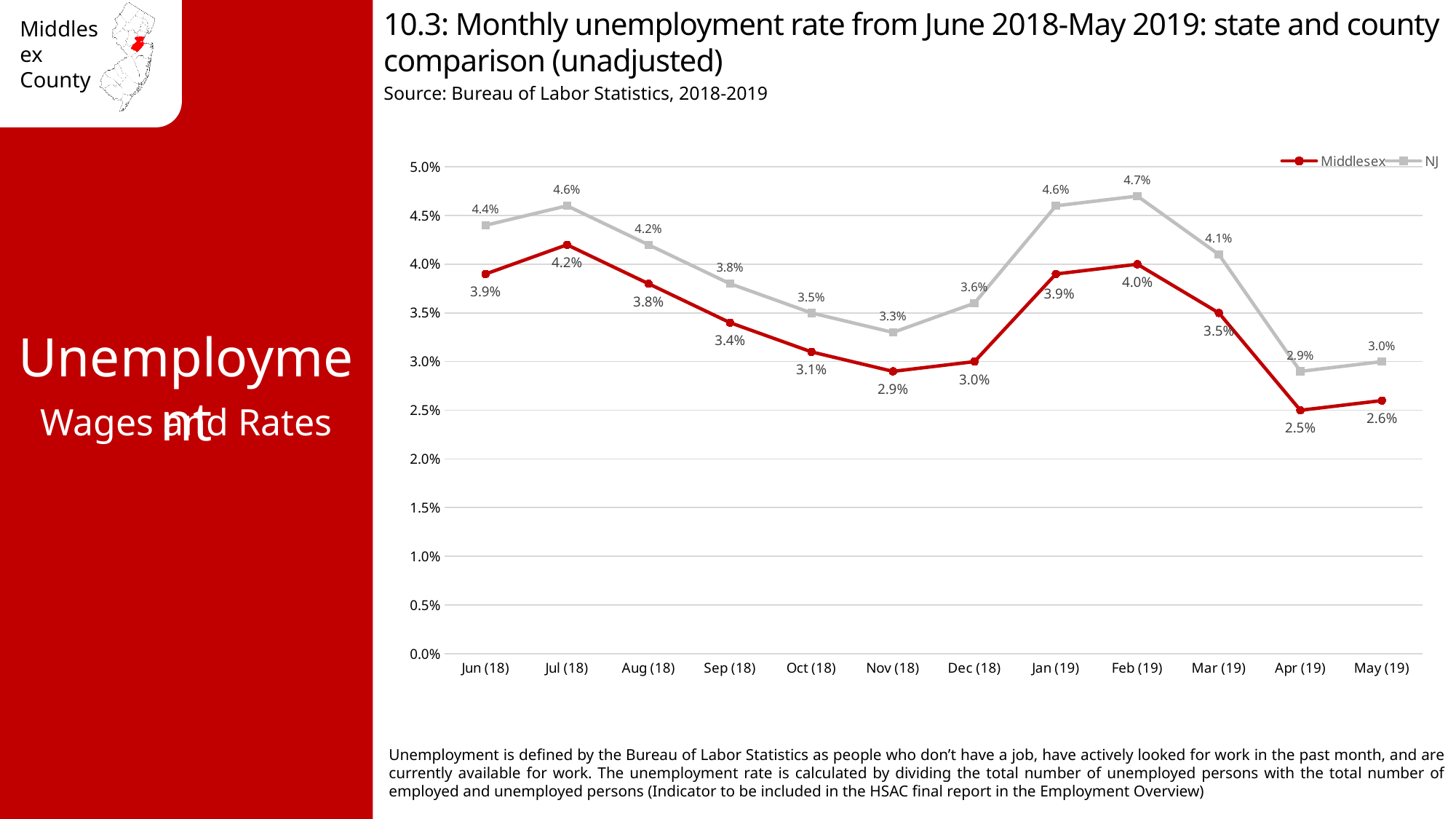
In which month was the Middlesex unemployment rate lowest? Apr (19) What was the NJ unemployment rate in Feb (19)? 4.7% What was the Middlesex unemployment rate in Nov (18)? 2.9% Is the Middlesex unemployment rate in Mar (19) greater or less than 3.0%? greater Which series had the higher unemployment rate in Oct (18), Middlesex or NJ? NJ In which month was the NJ unemployment rate highest? Feb (19) How many series does the legend list? 2 What is the difference between the NJ and Middlesex unemployment rates in Jan (19)? 0.7% What was the Middlesex unemployment rate in Jul (18)? 4.2% How many months are shown on the x axis? 12 What kind of chart is shown on the slide? Line chart Did the Middlesex unemployment rate rise or fall from Feb (19) to Apr (19)? Fall